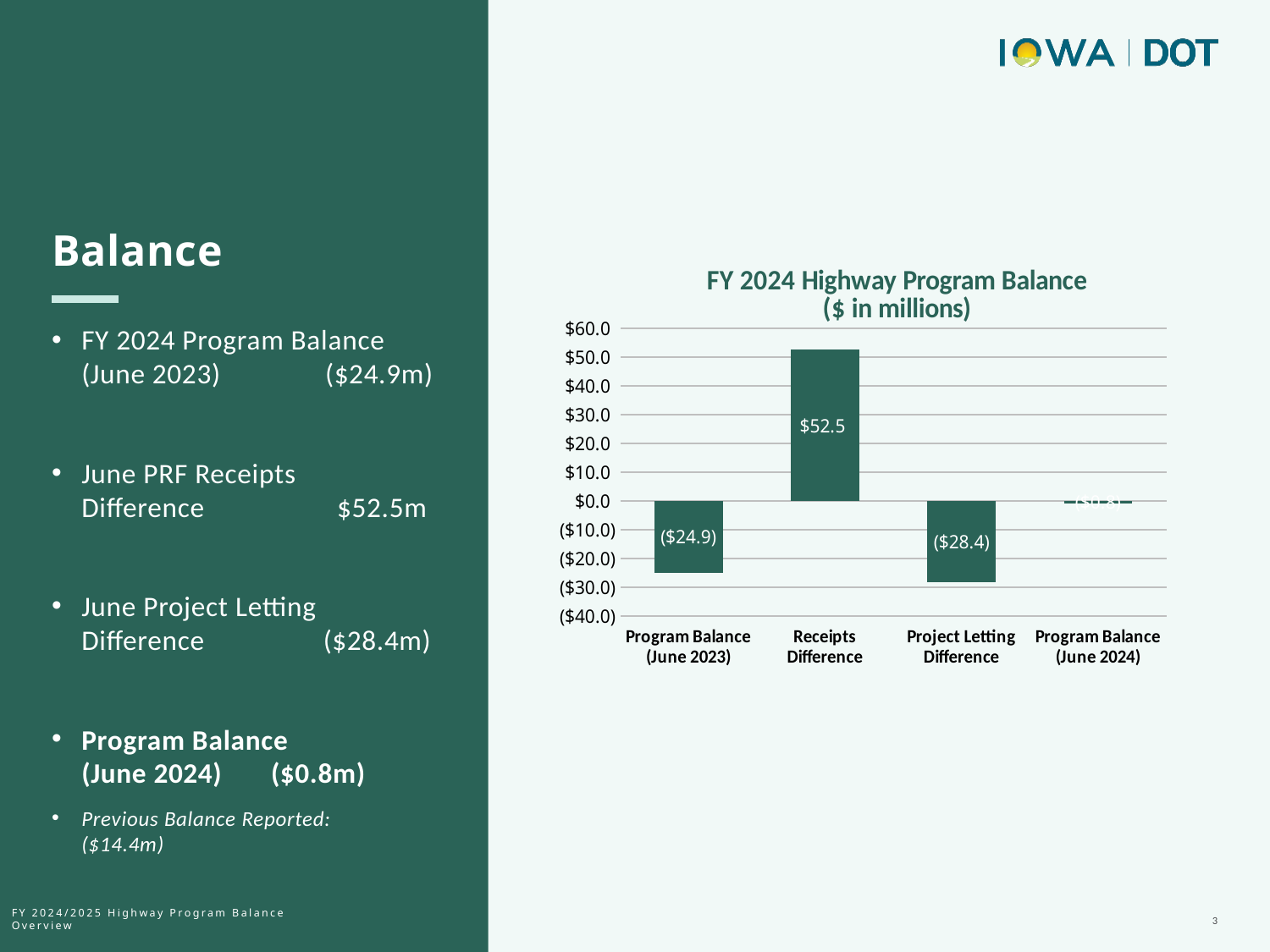
Is the value for Receipts Difference greater or less than $50.0? greater Which category has the lowest value in the chart? Project Letting Difference What is the difference between the Receipts Difference value and the Project Letting Difference value? $80.9 Which is larger, the value for Program Balance (June 2023) or the value for Project Letting Difference? Program Balance (June 2023) How many categories are shown on the x axis of the chart? 4 By how much does the Program Balance (June 2023) value differ from the Project Letting Difference value? $3.5 What is the value for Receipts Difference in the FY 2024 Highway Program Balance chart? $52.5 What kind of chart is shown on the slide? Bar chart What is the title of the chart? FY 2024 Highway Program Balance ($ in millions) What is the value for Project Letting Difference in the chart? ($28.4) What is the value for Program Balance (June 2023) in the chart? ($24.9) Which category has the highest value in the chart? Receipts Difference